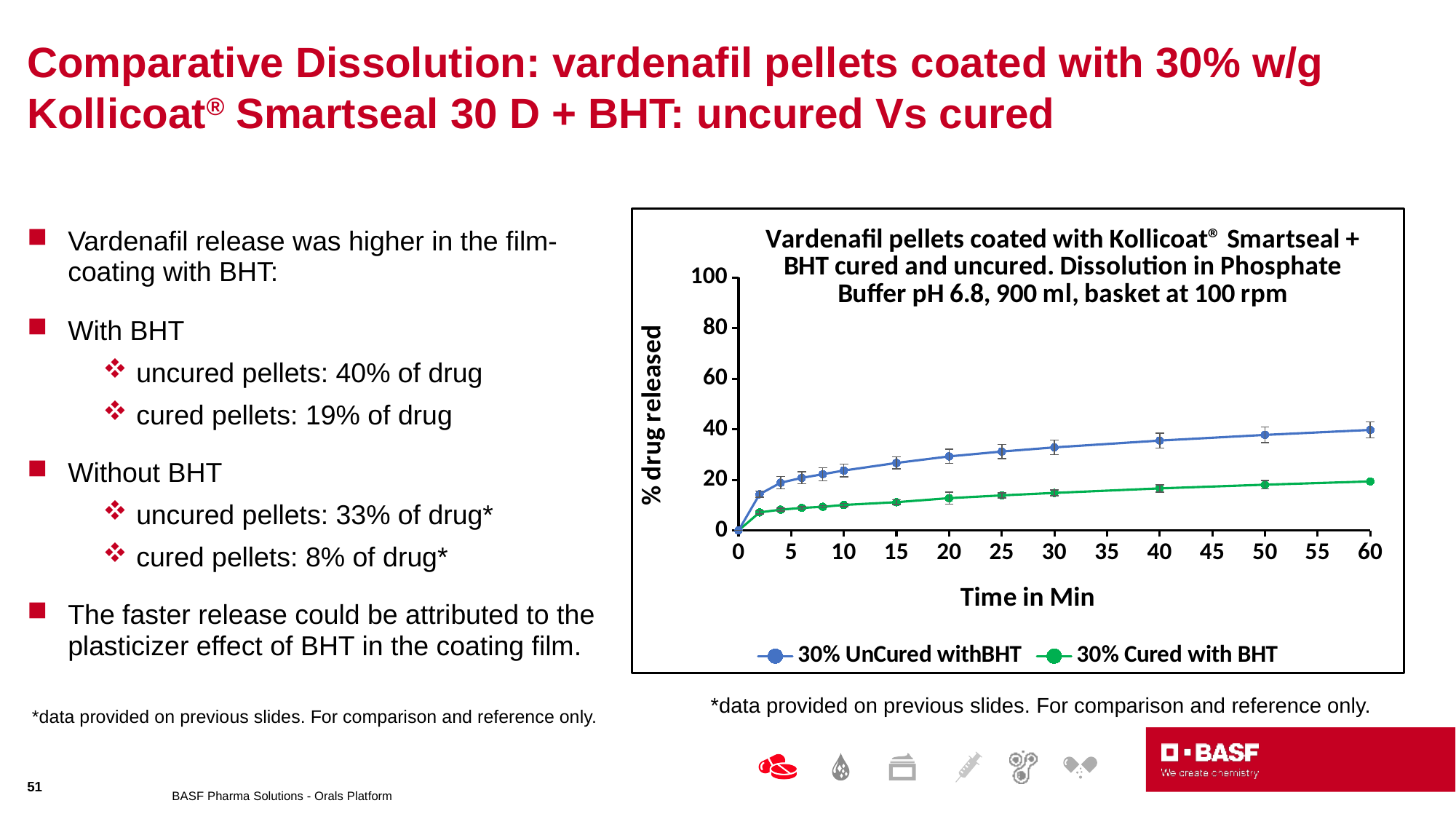
What is the label of the x axis of the chart? Time in Min What kind of chart is shown on the slide? line chart Is the value for 30% Cured with BHT at 30 minutes greater or less than 20? less Do the values for 30% Cured with BHT rise or fall as time increases along the x axis? rise How many series does the chart legend list? 2 Do the values for 30% UnCured withBHT rise or fall as time increases along the x axis? rise Is the value for 30% UnCured withBHT at 30 minutes greater or less than 40? less Which series has the lower value at 30 minutes? 30% Cured with BHT What are the two series named in the chart legend? 30% UnCured withBHT and 30% Cured with BHT Which series has the higher value at 60 minutes, 30% UnCured withBHT or 30% Cured with BHT? 30% UnCured withBHT Is the value for 30% UnCured withBHT at 30 minutes greater or less than 20? greater